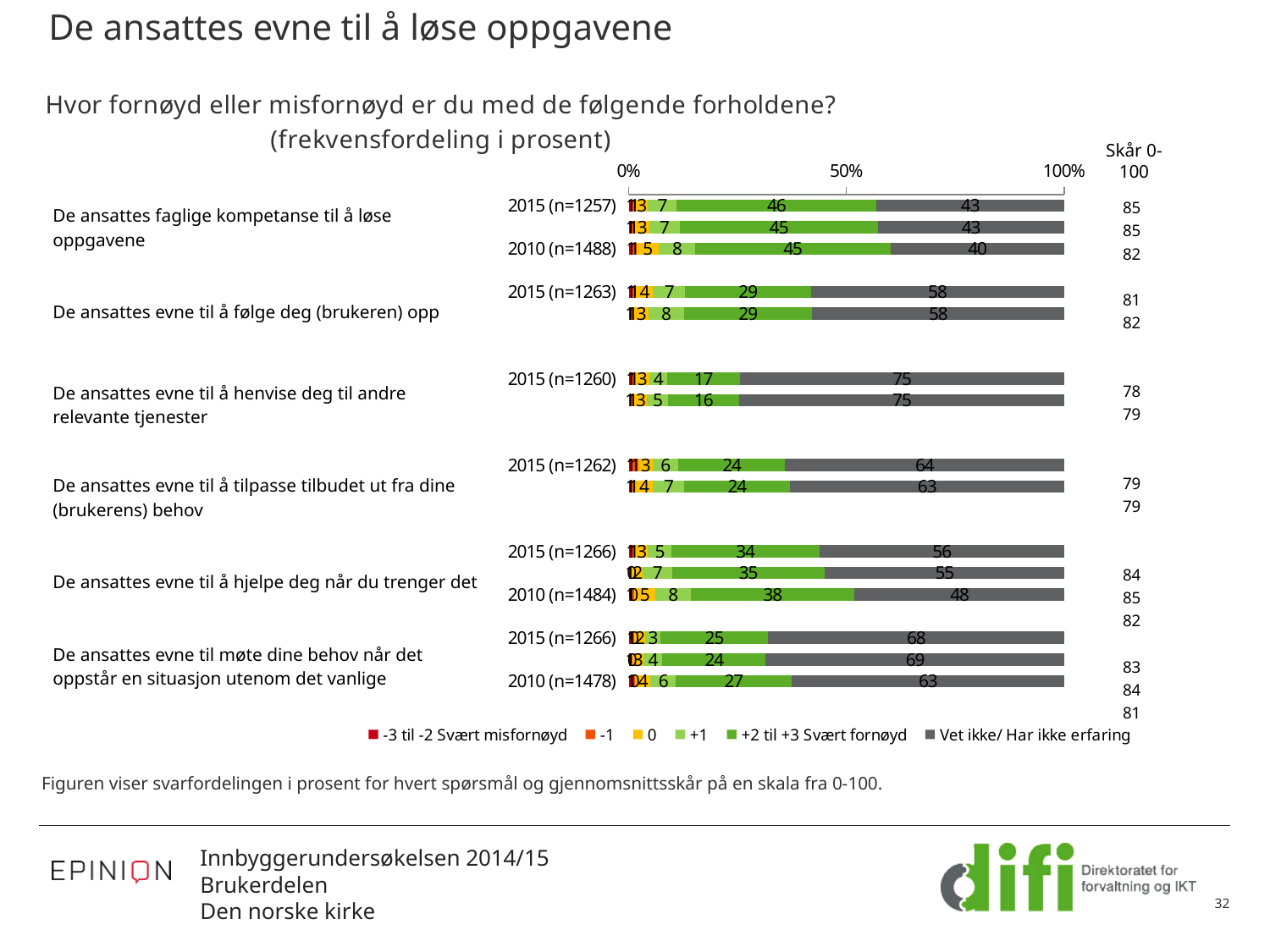
What is the 'Vet ikke/ Har ikke erfaring' percentage for 'De ansattes evne til å følge deg (brukeren) opp' in 2015 (n=1263)? 58 What is the '+2 til +3 Svært fornøyd' percentage for 'De ansattes evne til å henvise deg til andre relevante tjenester' in 2015 (n=1260)? 17 What is the '+2 til +3 Svært fornøyd' percentage for 'De ansattes evne til møte dine behov når det oppstår en situasjon utenom det vanlige' in 2010 (n=1478)? 27 How many series does the legend list? 6 Which legend entry is shown in grey? Vet ikke/ Har ikke erfaring For 'De ansattes faglige kompetanse til å løse oppgavene', what is the difference in the 'Vet ikke/ Har ikke erfaring' percentage between 2015 (n=1257) and 2010 (n=1488)? 3 What is the 'Skår 0-100' value for 'De ansattes faglige kompetanse til å løse oppgavene' in 2015 (n=1257)? 85 For 'De ansattes evne til å hjelpe deg når du trenger det', which year has the larger '+2 til +3 Svært fornøyd' percentage, 2015 (n=1266) or 2010 (n=1484)? 2010 (n=1484) What is the 'Vet ikke/ Har ikke erfaring' percentage for 'De ansattes faglige kompetanse til å løse oppgavene' in 2015 (n=1257)? 43 Among the 2015 rows, which question item has the highest 'Vet ikke/ Har ikke erfaring' percentage? De ansattes evne til å henvise deg til andre relevante tjenester How many question items (row groups) are shown in the chart? 6 What kind of chart is shown on the slide? bar chart